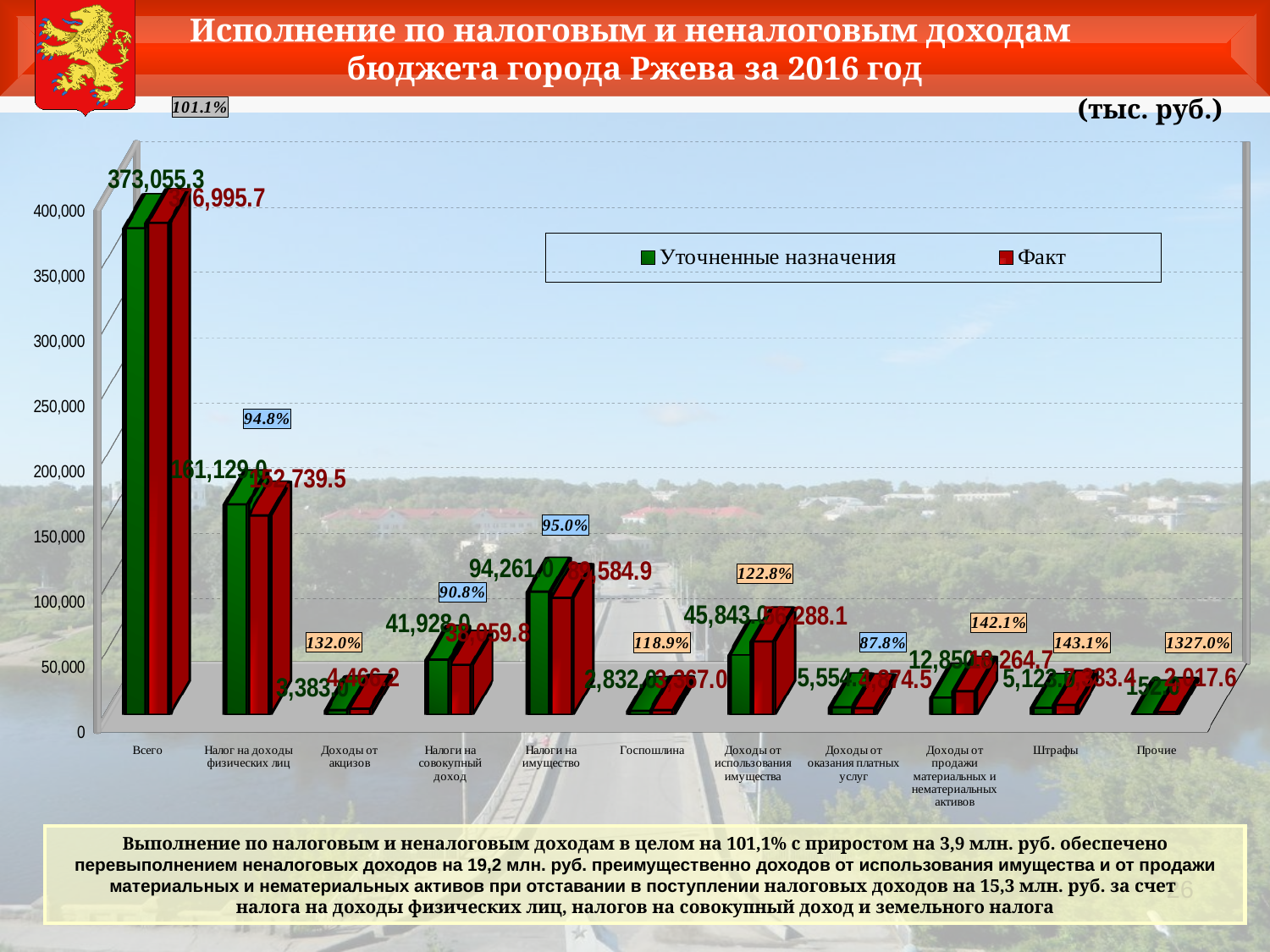
What is the value of Уточненные назначения for Налог на доходы физических лиц? 161,129.0 Which category has the highest values in the chart? Всего What is the difference between Уточненные назначения for Налоги на имущество and for Налоги на совокупный доход? 52,333.0 How many categories are shown along the x axis? 11 What is the value of Уточненные назначения for Налоги на совокупный доход? 41,928.0 What is the value of Уточненные назначения for Всего? 373,055.3 What is the value of Уточненные назначения for Налоги на имущество? 94,261.0 How many series does the legend list? 2 Is the Факт value for Налог на доходы физических лиц greater or less than 200,000? less What is the value of Уточненные назначения for Доходы от использования имущества? 45,843.0 Which is larger for Уточненные назначения: Налоги на имущество or Налоги на совокупный доход? Налоги на имущество What kind of chart is shown on the slide? bar chart